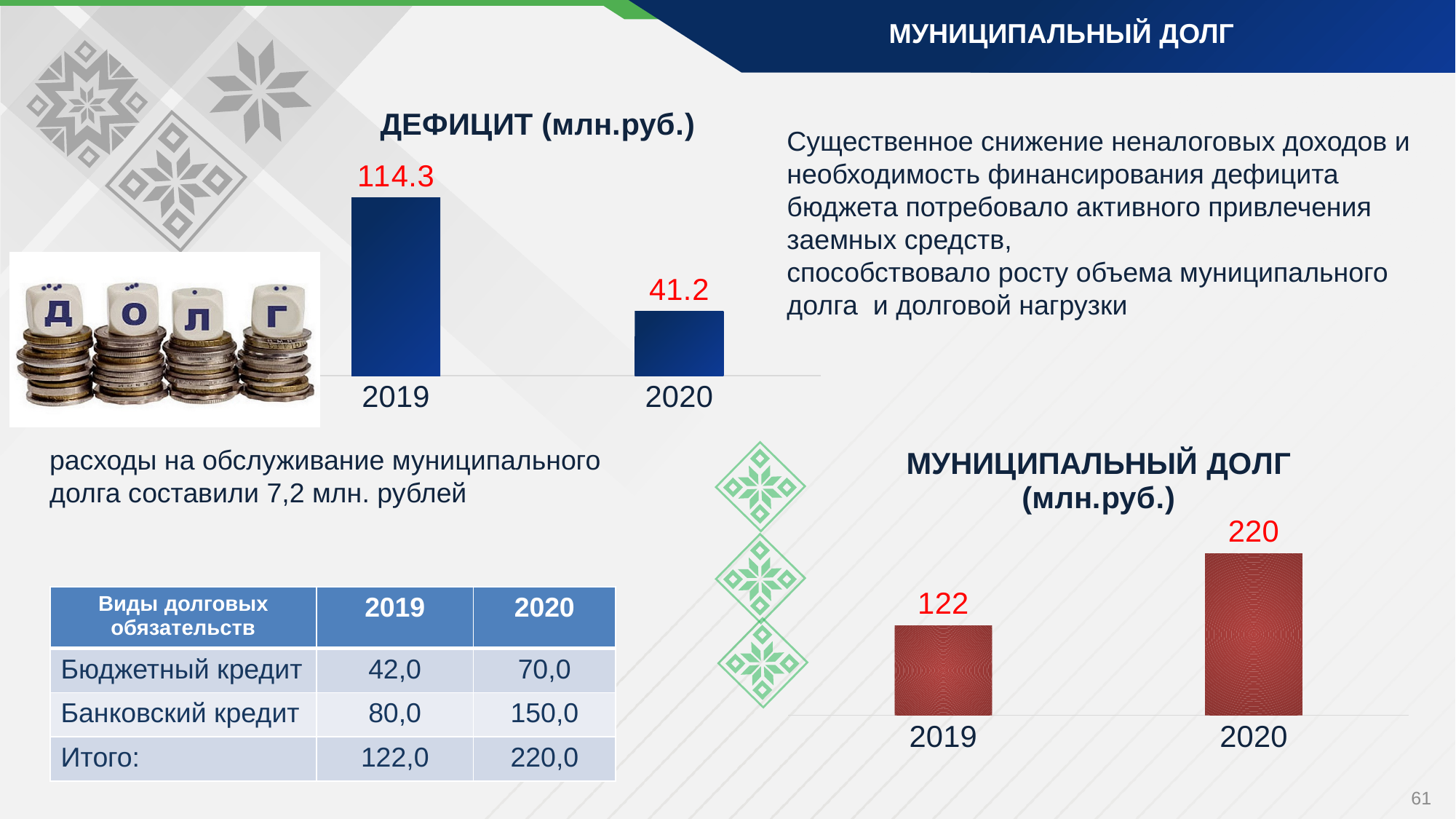
In the chart titled 'МУНИЦИПАЛЬНЫЙ ДОЛГ (млн.руб.)', what is the difference between the 2020 and 2019 values? 98 In the chart titled 'МУНИЦИПАЛЬНЫЙ ДОЛГ (млн.руб.)', which year has the lower value? 2019 In the chart titled 'МУНИЦИПАЛЬНЫЙ ДОЛГ (млн.руб.)', what is the value for 2019? 122 In the chart titled 'ДЕФИЦИТ (млн.руб.)', by how much does the value for 2019 exceed the value for 2020? 73.1 In the chart titled 'ДЕФИЦИТ (млн.руб.)', do the values rise or fall from 2019 to 2020? fall What type of chart is the chart titled 'МУНИЦИПАЛЬНЫЙ ДОЛГ (млн.руб.)'? bar chart In the chart titled 'ДЕФИЦИТ (млн.руб.)', which year has the higher value? 2019 In the chart titled 'ДЕФИЦИТ (млн.руб.)', what is the value for 2019? 114.3 In the chart titled 'МУНИЦИПАЛЬНЫЙ ДОЛГ (млн.руб.)', do the values rise or fall from 2019 to 2020? rise In the chart titled 'МУНИЦИПАЛЬНЫЙ ДОЛГ (млн.руб.)', what is the value for 2020? 220 In the chart titled 'ДЕФИЦИТ (млн.руб.)', how many bars are plotted? 2 In the chart titled 'ДЕФИЦИТ (млн.руб.)', what is the value for 2020? 41.2